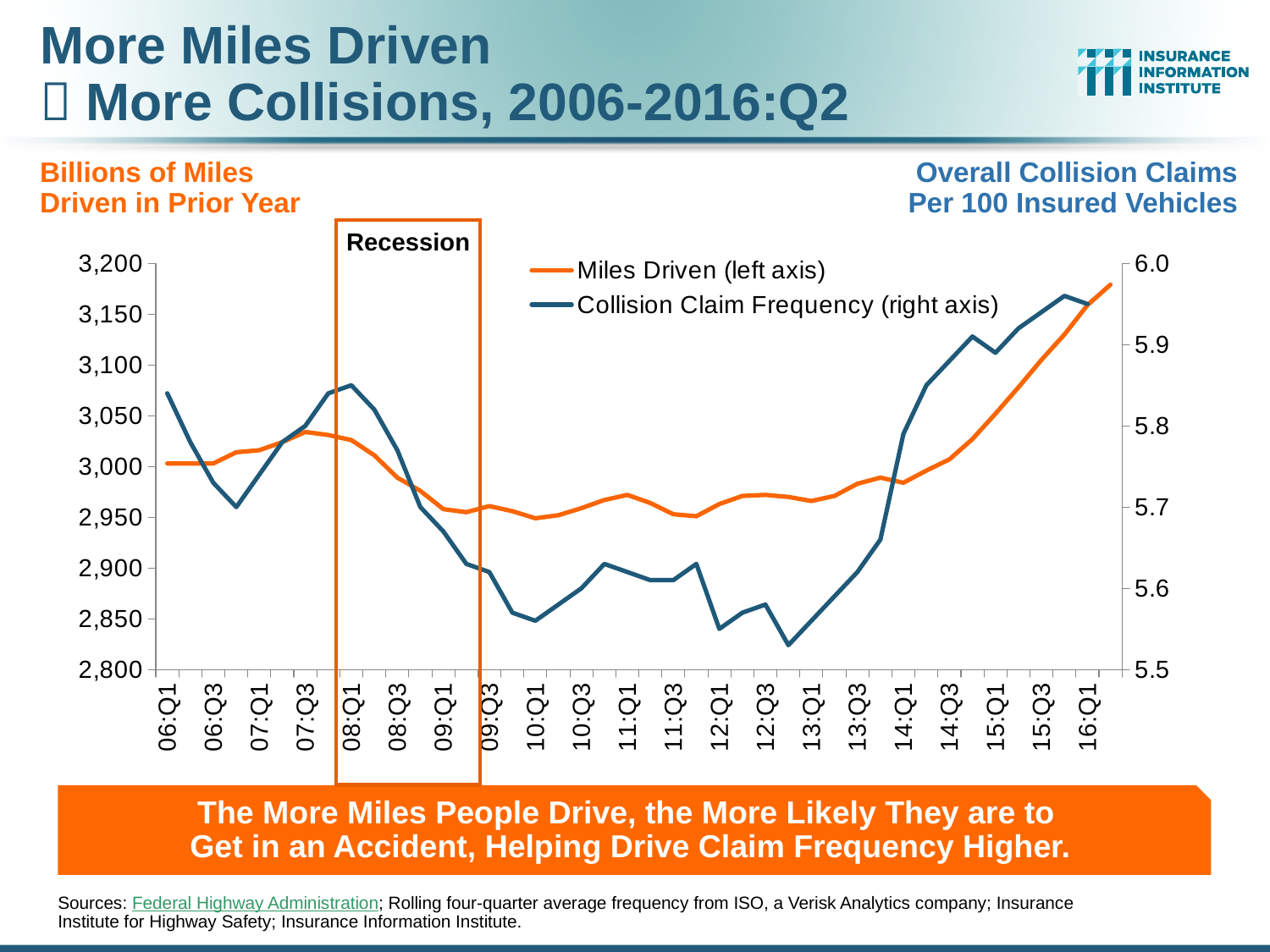
At which quarter is Miles Driven at its highest? 16:Q2 Which series is plotted against the right axis? Collision Claim Frequency How many series does the legend list? 2 Is the value for Collision Claim Frequency at 16:Q1 greater or less than 5.9? greater What label is shown on the highlighted box over 2008-2009? Recession At which quarter is Collision Claim Frequency at its lowest? 12:Q4 Is the value for Collision Claim Frequency at 12:Q3 greater or less than 5.6? less What kind of chart is shown on the slide? line chart Does Miles Driven rise or fall from 13:Q1 to 16:Q1? rise Is the value for Miles Driven at 10:Q1 greater or less than 3,000? less Which is larger, Collision Claim Frequency at 08:Q1 or at 12:Q3? 08:Q1